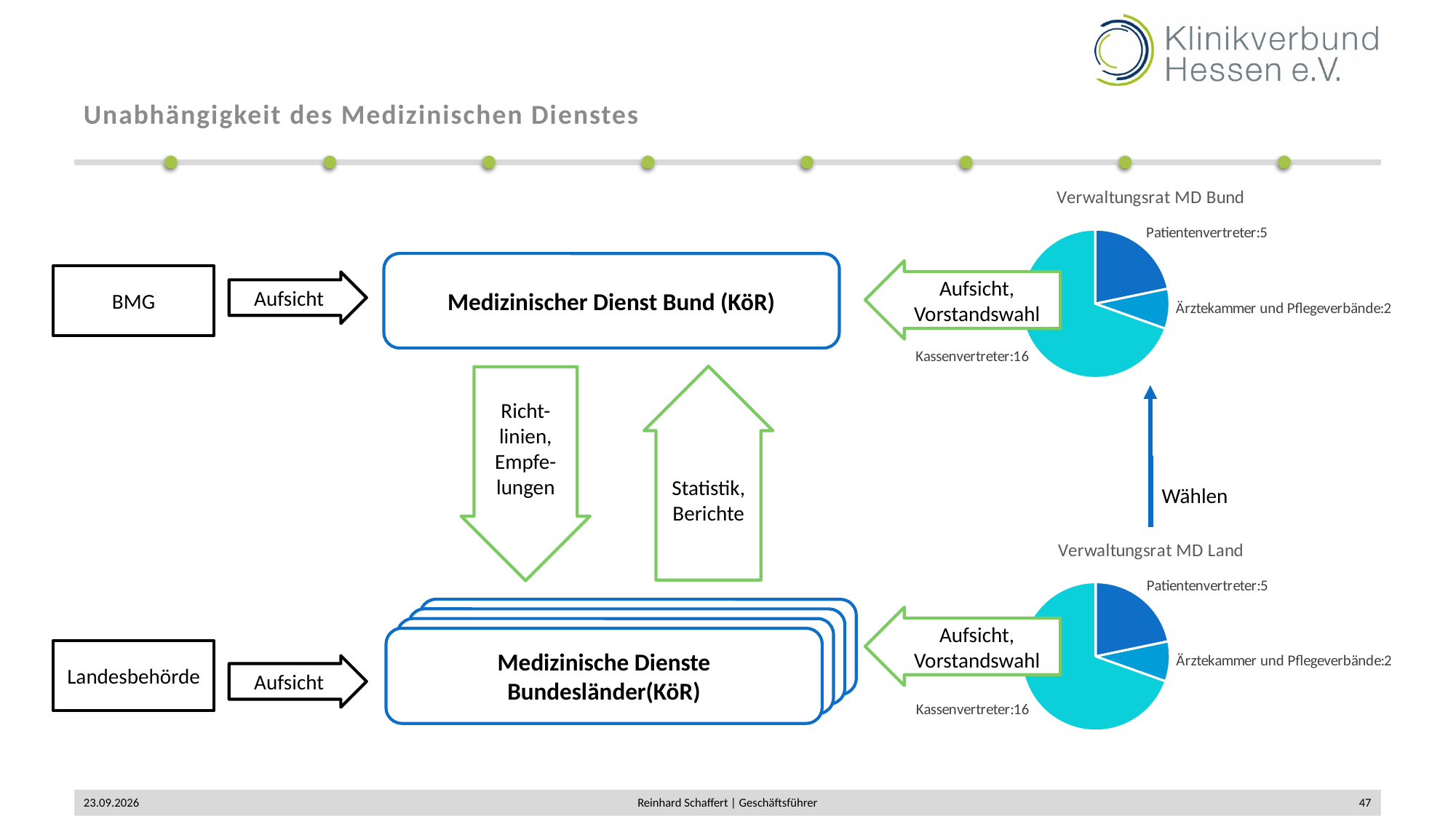
How many pie charts are shown on the slide? 2 In the 'Verwaltungsrat MD Land' chart, what is the value for Ärztekammer und Pflegeverbände? 2 In the 'Verwaltungsrat MD Land' chart, what is the difference between the Patientenvertreter and Ärztekammer und Pflegeverbände values? 3 In the 'Verwaltungsrat MD Bund' chart, which group has the largest slice? Kassenvertreter In the 'Verwaltungsrat MD Bund' chart, what is the value for Kassenvertreter? 16 In the 'Verwaltungsrat MD Bund' chart, what is the total of all slices? 23 In the 'Verwaltungsrat MD Land' chart, which is larger, Patientenvertreter or Ärztekammer und Pflegeverbände? Patientenvertreter In the 'Verwaltungsrat MD Land' chart, which group has the smallest slice? Ärztekammer und Pflegeverbände In the 'Verwaltungsrat MD Bund' chart, what is the difference between the Kassenvertreter and Patientenvertreter values? 11 In the 'Verwaltungsrat MD Bund' chart, what kind of chart is shown? pie chart How many slices does the 'Verwaltungsrat MD Land' pie chart have? 3 In the 'Verwaltungsrat MD Bund' chart, what is the value for Patientenvertreter? 5